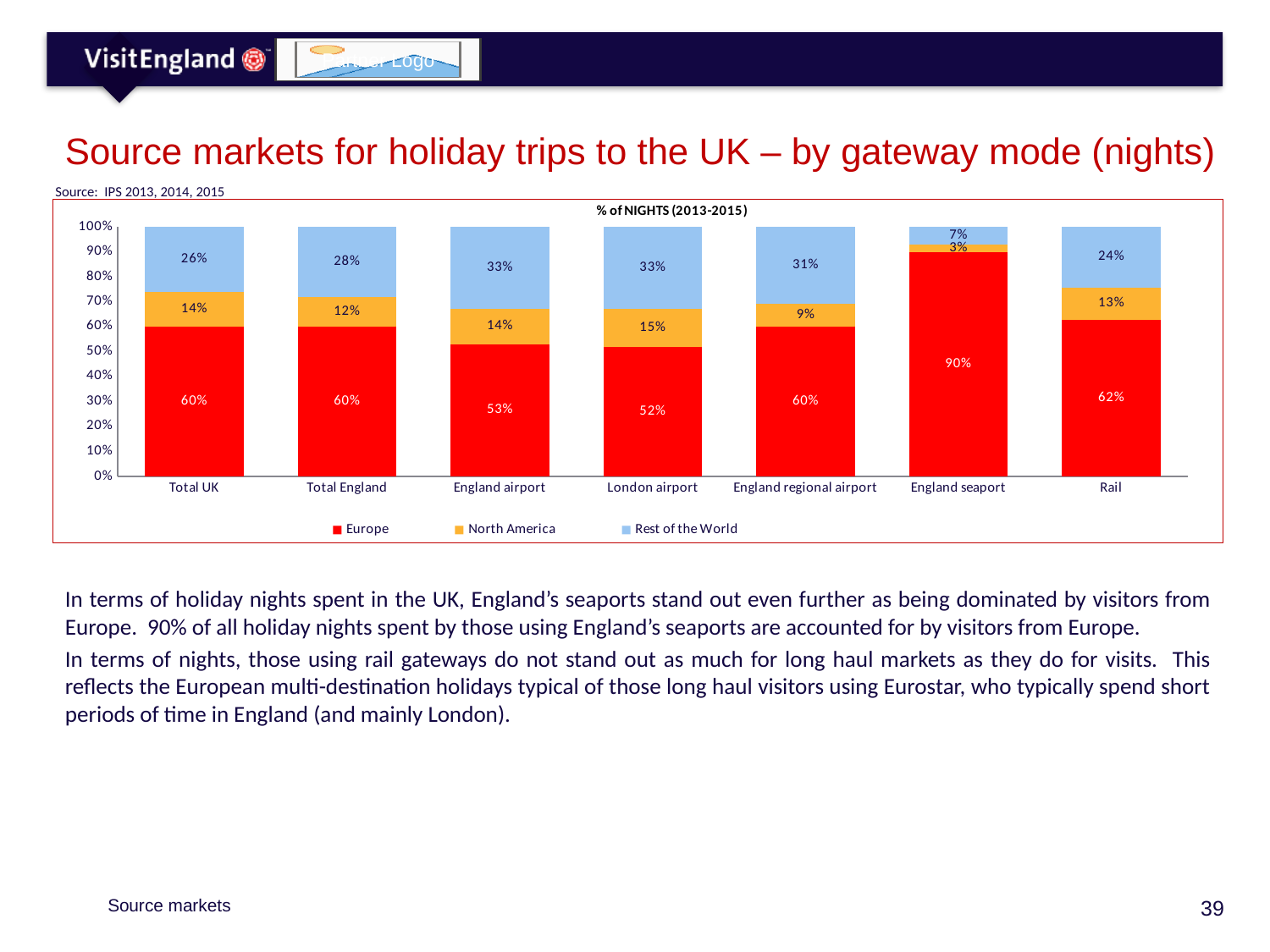
Which gateway category has the lowest Rest of the World share of nights? England seaport What is the Europe share of nights for England seaport? 90% How many gateway categories are shown on the x axis? 7 What is the combined share of Europe and North America for Total England? 72% What is the Rest of the World share of nights for Rail? 24% Which gateway category has the highest Europe share of nights? England seaport How many series does the legend list? 3 What is the difference between the Europe share for England seaport and for London airport? 38% What is the title printed above the chart's plot area? % of NIGHTS (2013-2015) What is the North America share of nights for London airport? 15% What kind of chart is shown on the slide? Stacked bar chart Which is larger: the North America share for Total UK or for England regional airport? Total UK